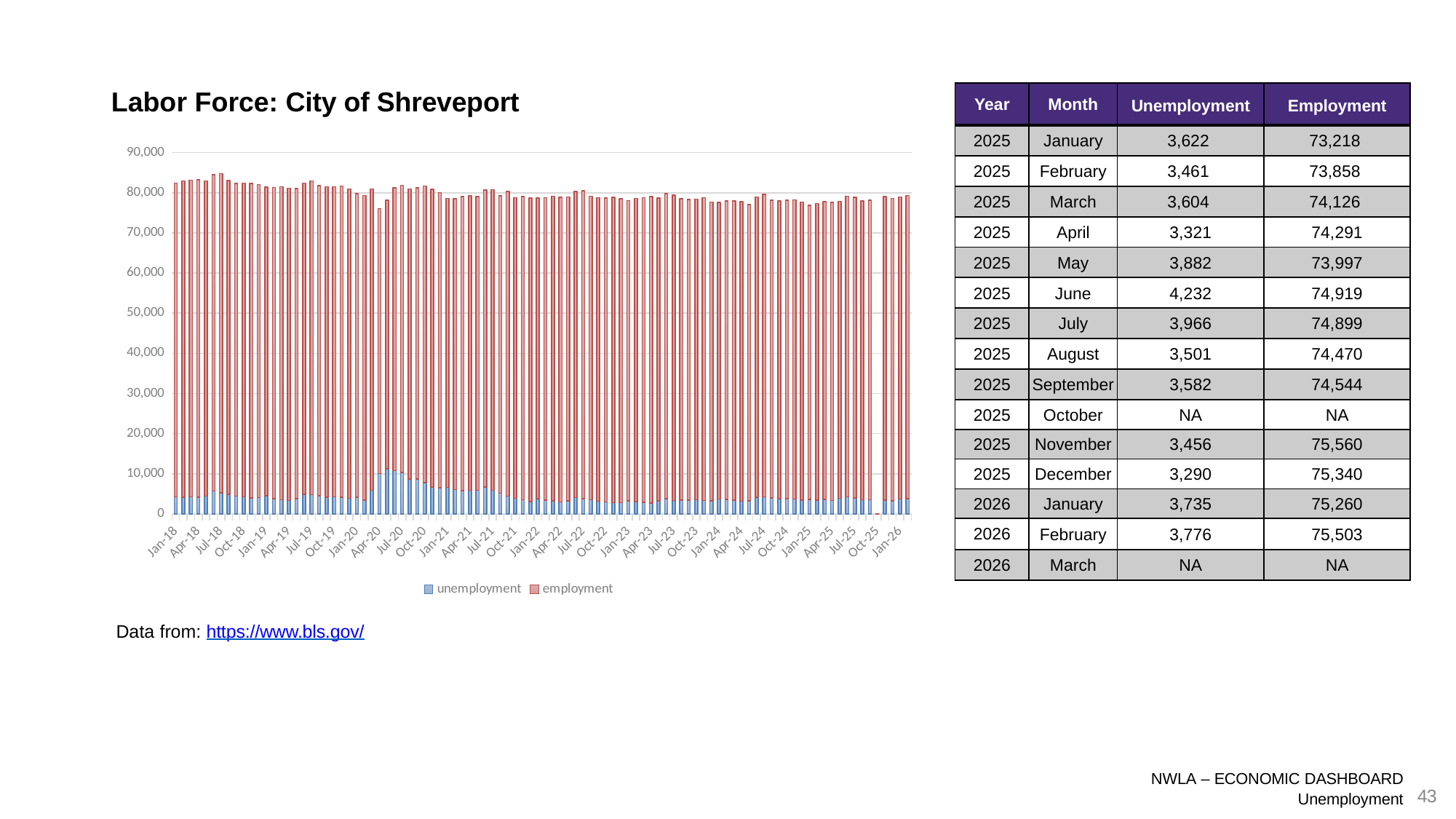
According to the table on the slide, what is the difference between employment in February 2026 and January 2026? 243 Is the unemployment value for Jan-18 greater or less than 10,000? less How many series does the chart legend list? 2 According to the table on the slide, what is the unemployment value for June 2025? 4,232 Is the employment value for Apr-20 greater or less than 80,000? less What kind of chart is shown on the slide? bar chart What are the two series named in the chart legend? unemployment and employment Which series has the larger value in Jan-22, unemployment or employment? employment In which year does the unemployment series reach its highest point on the chart? 2020 What is the title of the chart? Labor Force: City of Shreveport Does the unemployment series rise or fall from Jul-20 to Jan-21? fall